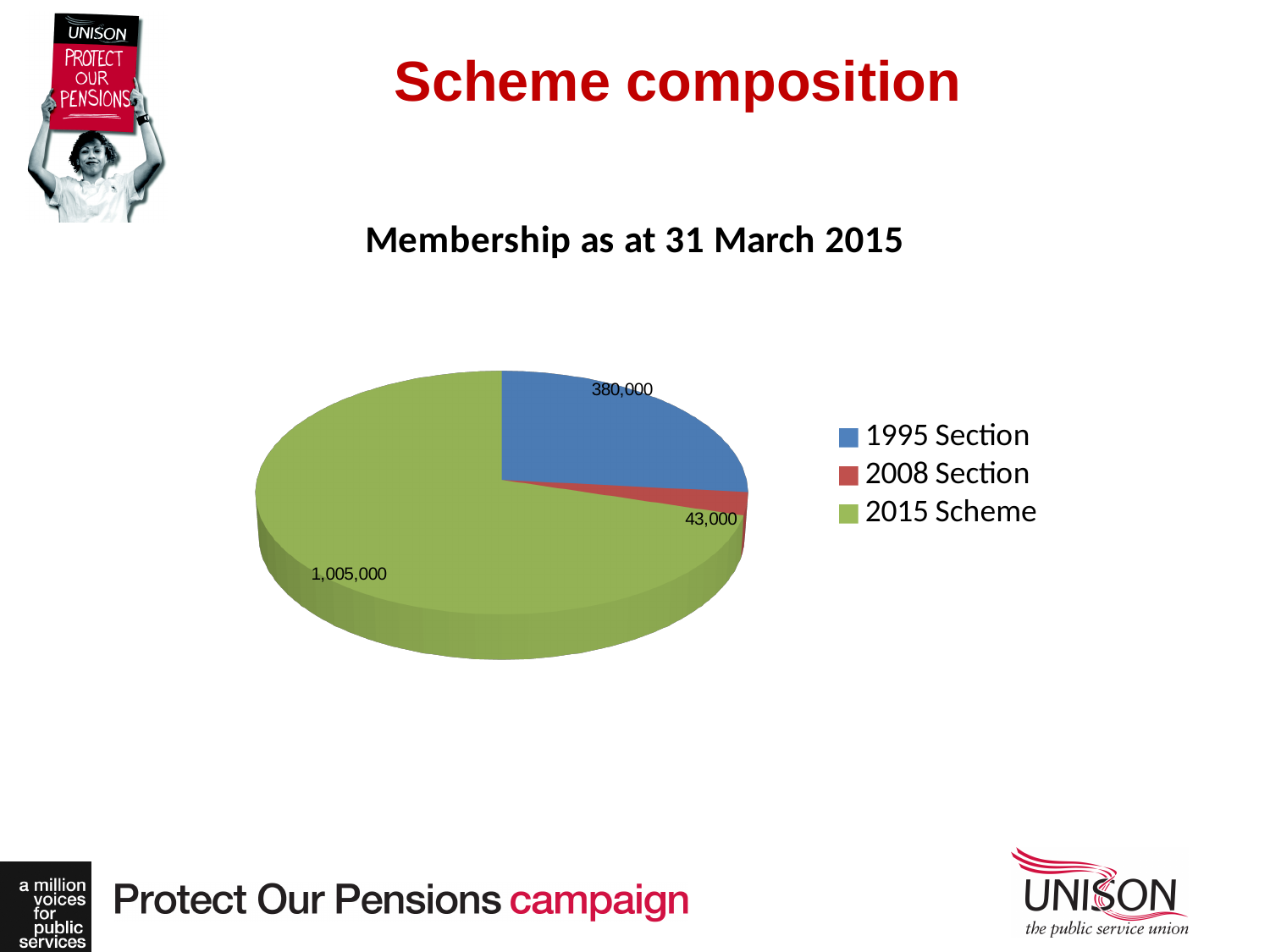
What is the difference in membership between the 2015 Scheme and the 1995 Section? 625,000 What type of chart is shown on the slide? Pie chart What is the membership value for the 1995 Section? 380,000 What is the chart's title? Membership as at 31 March 2015 Which is larger, the membership of the 1995 Section or the 2008 Section? 1995 Section What is the difference in membership between the 1995 Section and the 2008 Section? 337,000 Which category has the largest membership? 2015 Scheme What is the total membership across all three slices? 1,428,000 What is the membership value for the 2008 Section? 43,000 Which category has the smallest membership? 2008 Section How many slices does the pie chart have? 3 What is the membership value for the 2015 Scheme? 1,005,000